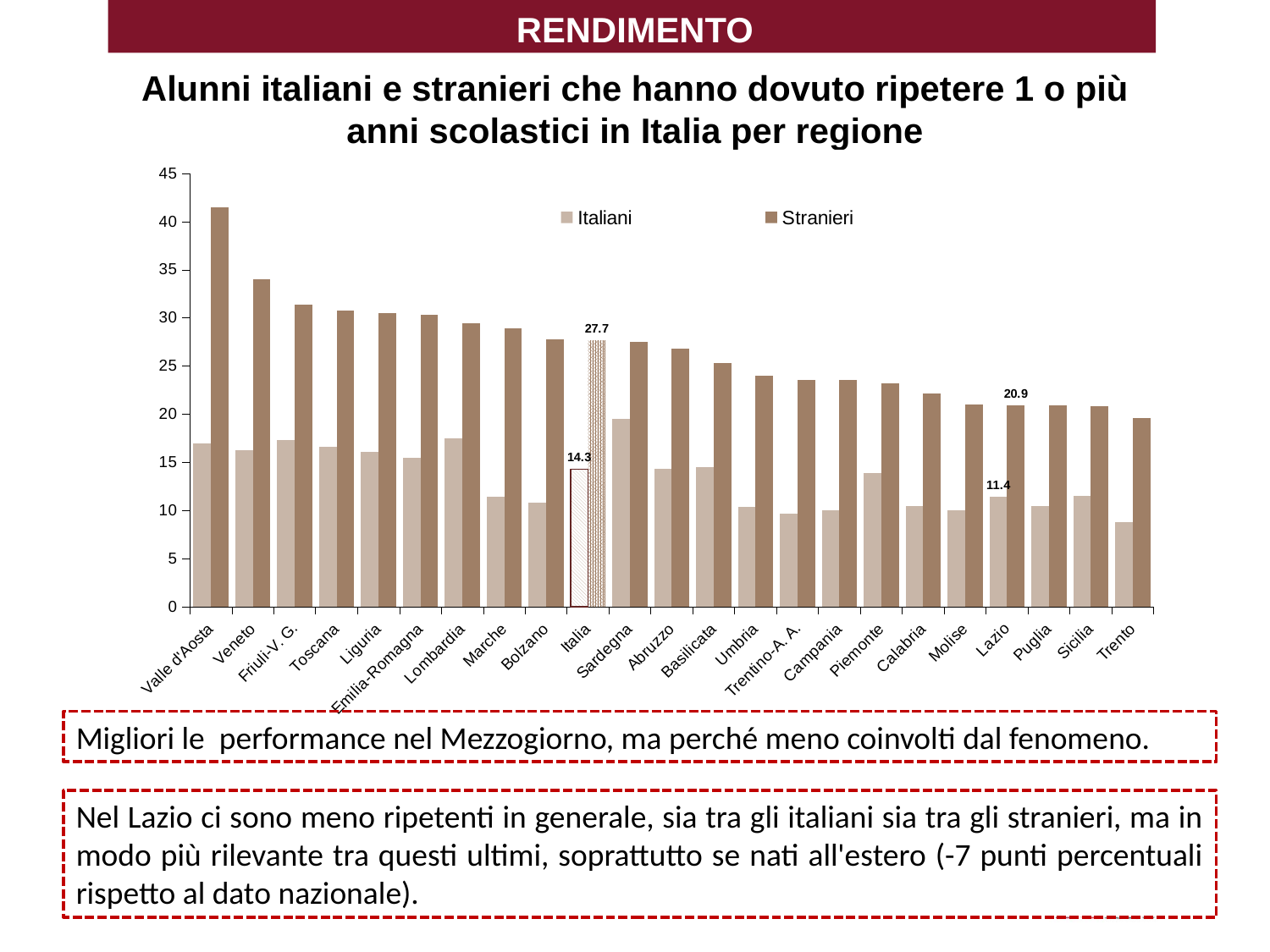
What is the value for Stranieri in Italia? 27.7 What is the difference between the Stranieri values for Italia and Lazio? 6.8 Which category has the lowest value for Italiani? Trento Is the Italiani value for Trento greater or less than 10? less How many series does the legend list? 2 What is the value for Italiani in Lazio? 11.4 Do the Stranieri values generally rise or fall from left to right along the x axis? fall What is the value for Italiani in Italia? 14.3 What is the value for Stranieri in Lazio? 20.9 Which region has the highest value for Stranieri? Valle d'Aosta What is the difference between the Stranieri and Italiani values for Italia? 13.4 Is the Stranieri value for Valle d'Aosta greater or less than 40? greater